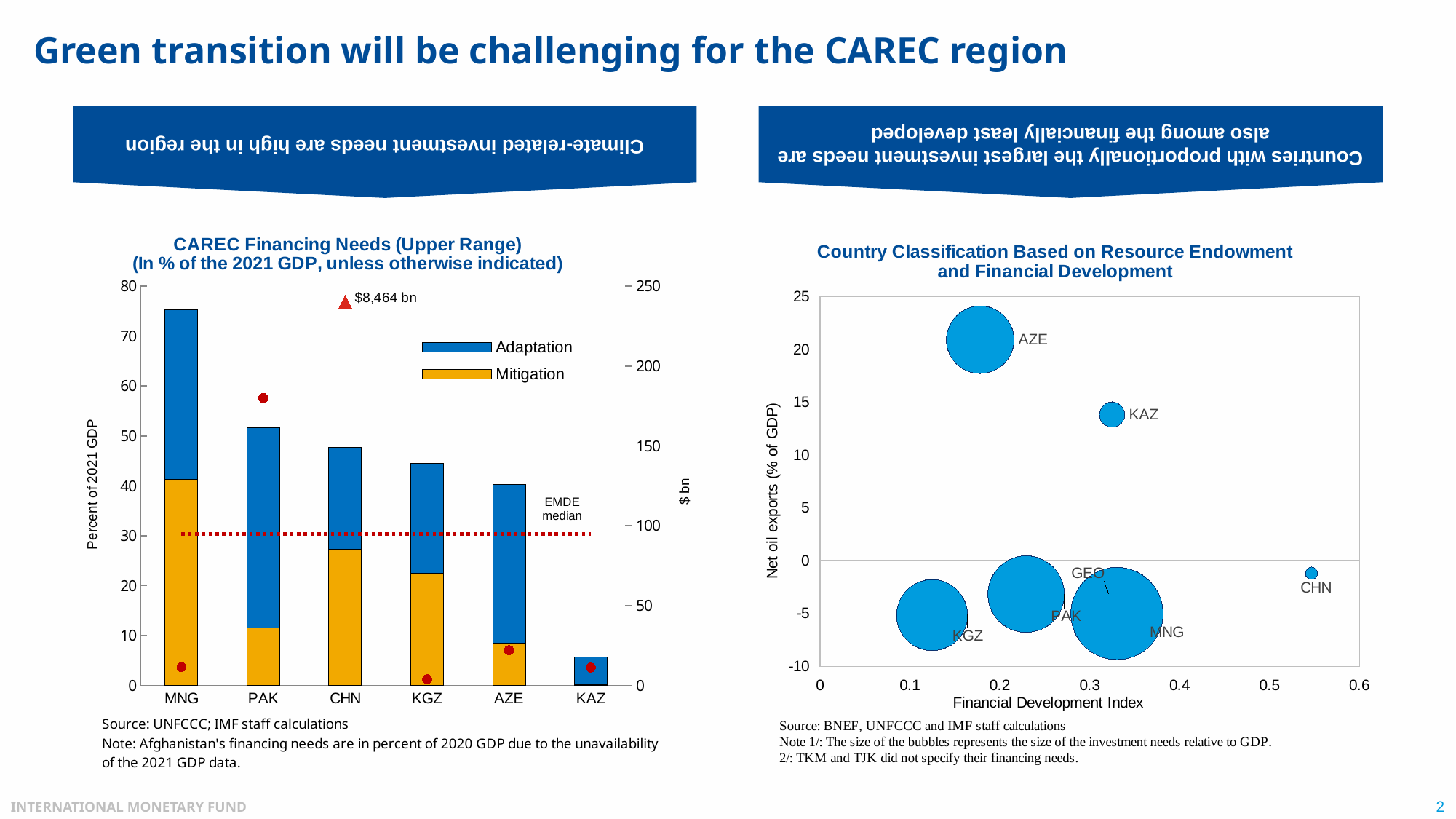
How many countries are shown on the x axis of the 'CAREC Financing Needs (Upper Range)' chart? 6 How many series does the legend of the 'CAREC Financing Needs (Upper Range)' chart list? 2 In the 'CAREC Financing Needs (Upper Range)' chart, which colour represents Adaptation? Blue In the 'CAREC Financing Needs (Upper Range)' chart, is the total bar for MNG greater or less than 70 percent of 2021 GDP? greater In the 'Country Classification Based on Resource Endowment and Financial Development' chart, which country has the highest net oil exports as a percent of GDP? AZE In the 'CAREC Financing Needs (Upper Range)' chart, what dollar value is labelled next to the red triangle for CHN? $8,464 bn In the 'CAREC Financing Needs (Upper Range)' chart, do the total bar heights rise or fall moving from MNG to KAZ along the x axis? fall In the 'CAREC Financing Needs (Upper Range)' chart, which country has the lowest total financing need as a percent of 2021 GDP? KAZ In the 'CAREC Financing Needs (Upper Range)' chart, is the total bar for KGZ greater or less than 50 percent of 2021 GDP? less In the 'Country Classification Based on Resource Endowment and Financial Development' chart, is the Financial Development Index for CHN greater or less than 0.5? greater What kind of chart is the 'CAREC Financing Needs (Upper Range)' chart on the left? Stacked bar chart In the 'CAREC Financing Needs (Upper Range)' chart, which country has the highest total financing need as a percent of 2021 GDP? MNG